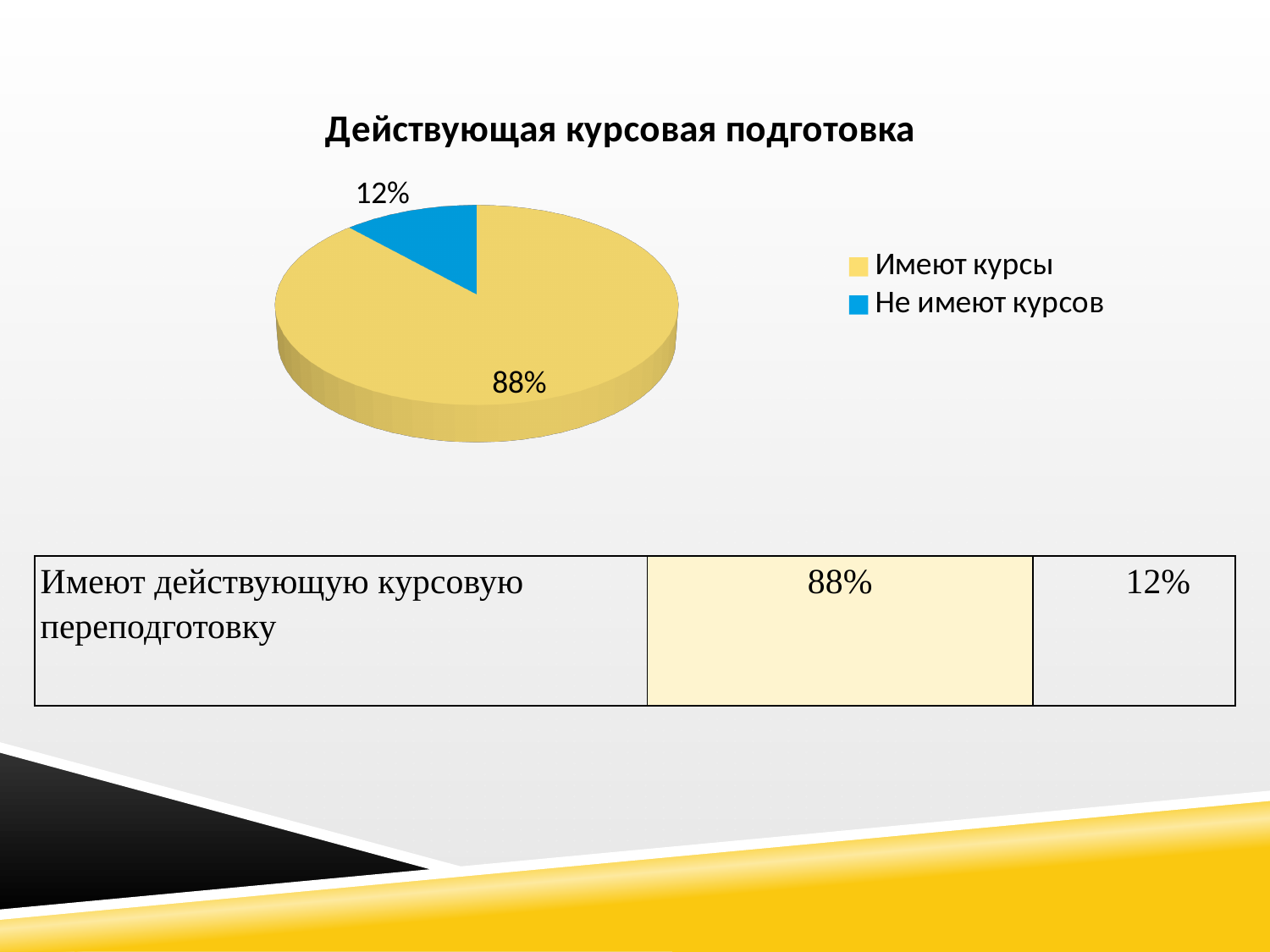
How many slices does the pie chart have? 2 What share of the pie does "Не имеют курсов" take? 12% How many entries does the legend list? 2 Which category has the smallest slice of the pie? Не имеют курсов What colour is the slice for "Не имеют курсов"? Blue What is the title of the chart? Действующая курсовая подготовка Which category has the largest slice of the pie? Имеют курсы What is the difference in percentage points between "Имеют курсы" and "Не имеют курсов"? 76 What kind of chart is shown on the slide? Pie chart Which is larger: the share for "Имеют курсы" or for "Не имеют курсов"? Имеют курсы What share of the pie does "Имеют курсы" take? 88%